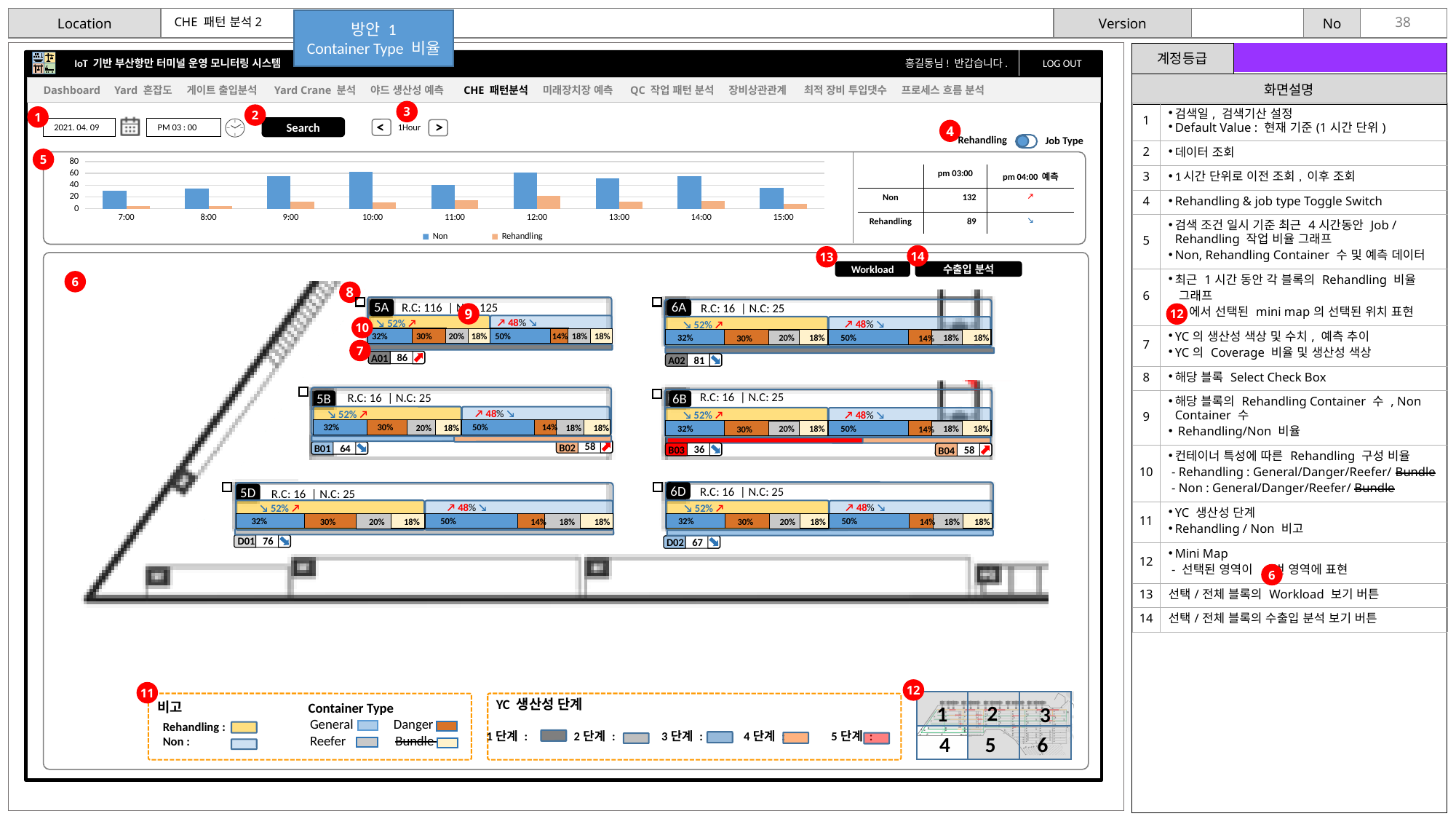
In the top bar chart, is the Non value at 10:00 greater or less than 40? greater In the top bar chart, is the Non value at 7:00 greater or less than 40? less How many time points are shown on the x axis of the top bar chart? 9 In the top bar chart, is the Non value at 11:00 greater or less than 60? less How many series does the legend of the top bar chart list? 2 In the top bar chart, at which time is the Rehandling bar highest? 12:00 What kind of chart is the Non / Rehandling chart at the top of the dashboard (item 5)? bar chart In the top bar chart, which Non bar is taller: 9:00 or 7:00? 9:00 In the top bar chart, do the Non values rise or fall from 7:00 to 10:00? rise In the top bar chart, what colour represents the Rehandling series in the legend? orange In the top bar chart, which is larger at 12:00: the Non bar or the Rehandling bar? Non